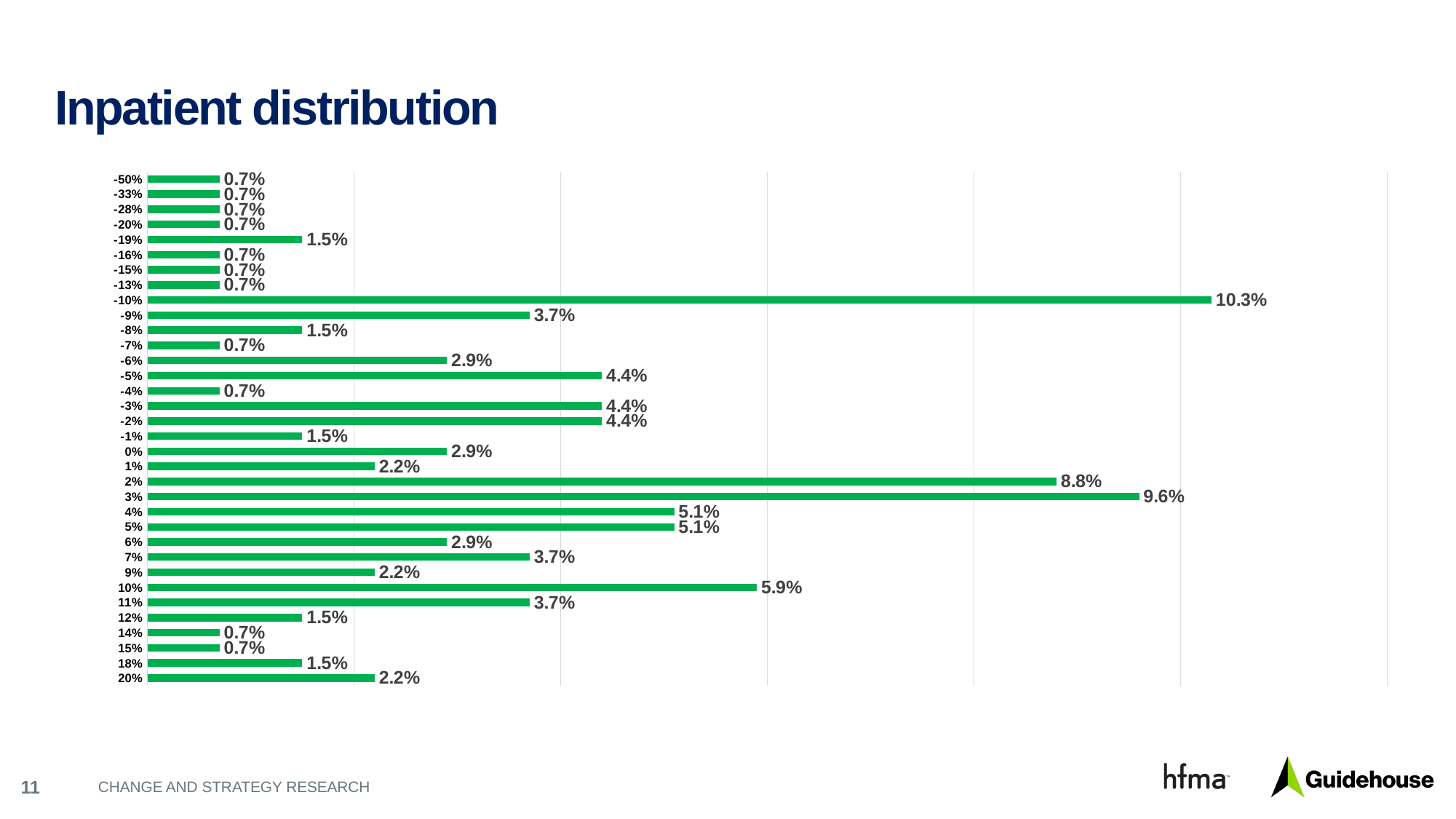
What is the value for the -10% category? 10.3% What is the value for the 3% category? 9.6% Which has a larger value, the 2% category or the 4% category? 2% Which category has the highest value? -10% What is the value for the 10% category? 5.9% What is the value for the -19% category? 1.5% What is the difference between the values for the -10% and 3% categories? 0.7% Which has a larger value, the -9% category or the -6% category? -9% What is the title of the slide? Inpatient distribution What is the difference between the values for the 2% and 10% categories? 2.9% What kind of chart is shown on the slide? Bar chart How many categories are shown in the chart? 34